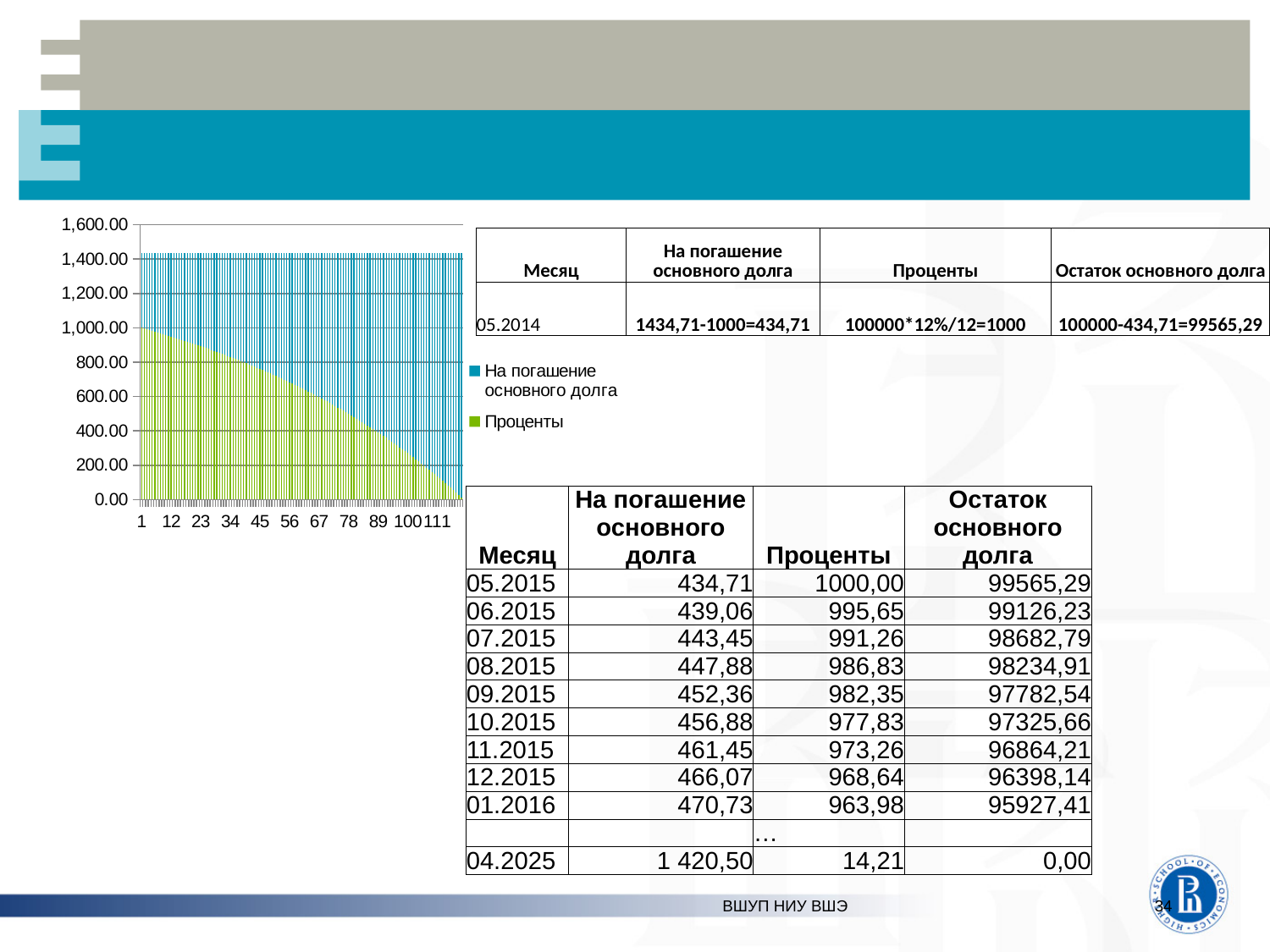
How many series does the chart legend list? 2 What kind of chart is shown on the left of the slide? bar chart Which series is shown in green in the chart? Проценты Is the Проценты value at month 1 greater or less than 800.00? greater Is the top of the bar at month 1 greater or less than 1,200.00? greater Is the Проценты value at month 56 greater or less than 800.00? less What is the highest value shown on the chart's vertical axis? 1,600.00 Which is larger for the Проценты series: the value at month 1 or the value at month 100? month 1 Do the values of the Проценты series rise or fall as the month number increases along the x axis? fall